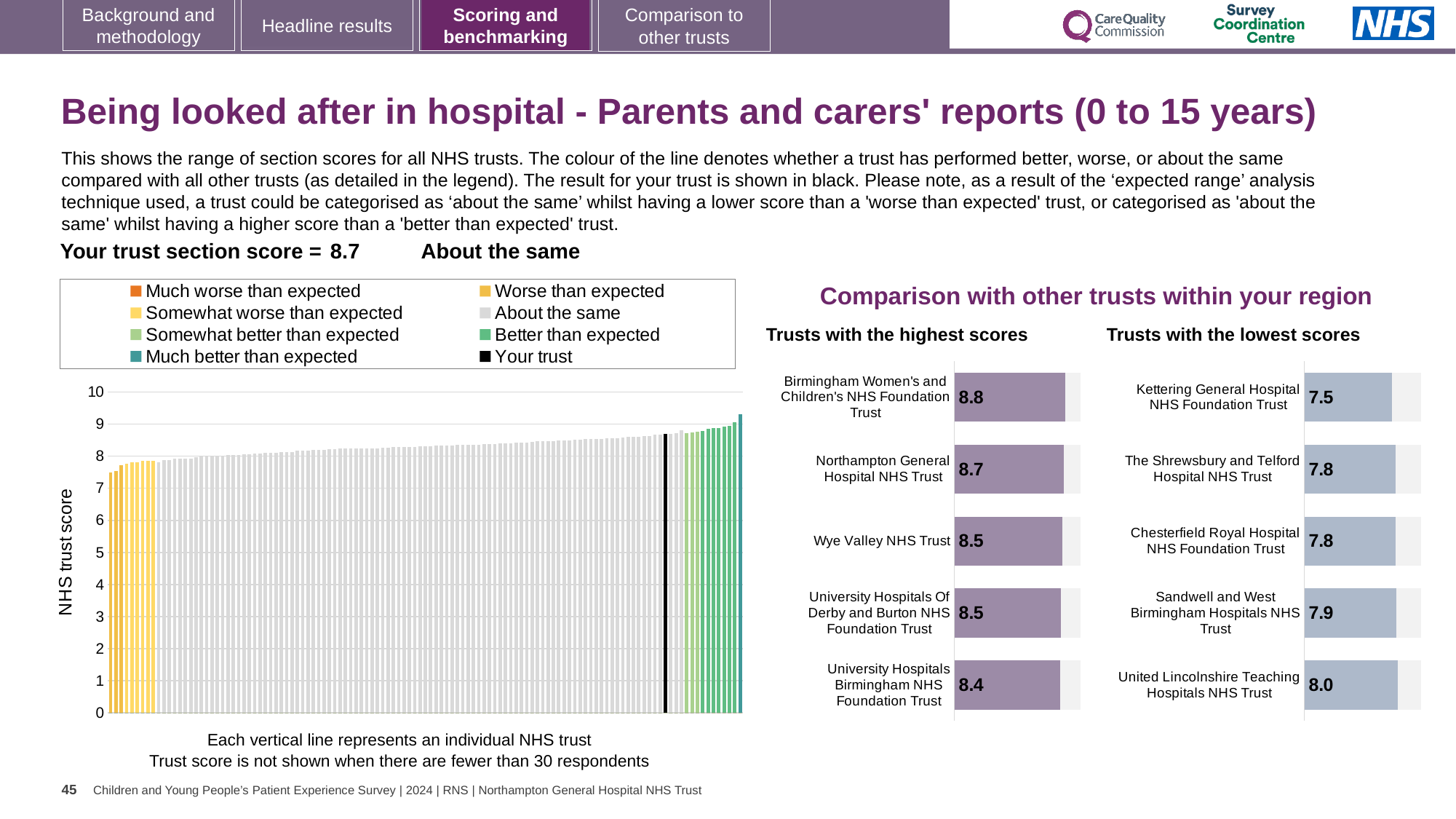
In the 'Trusts with the lowest scores' chart, what is the score for Kettering General Hospital NHS Foundation Trust? 7.5 In the 'Trusts with the lowest scores' chart, which trust has the lowest score? Kettering General Hospital NHS Foundation Trust In the 'Trusts with the highest scores' chart, what is the score for Birmingham Women's and Children's NHS Foundation Trust? 8.8 In the 'Trusts with the lowest scores' chart, what is the difference between the scores of United Lincolnshire Teaching Hospitals NHS Trust and Kettering General Hospital NHS Foundation Trust? 0.5 In the main 'NHS trust score' chart, do the values rise or fall from left to right? Rise How many entries does the legend of the main 'NHS trust score' chart list? 8 What kind of chart is the main chart on the left showing NHS trust scores? Bar chart In the 'Trusts with the highest scores' chart, what is the difference between the scores of Birmingham Women's and Children's NHS Foundation Trust and University Hospitals Birmingham NHS Foundation Trust? 0.4 In the 'Trusts with the highest scores' chart, which trust has the highest score? Birmingham Women's and Children's NHS Foundation Trust What is the label on the vertical axis of the main chart on the left? NHS trust score In the 'Trusts with the lowest scores' chart, which has the larger score: Sandwell and West Birmingham Hospitals NHS Trust or The Shrewsbury and Telford Hospital NHS Trust? Sandwell and West Birmingham Hospitals NHS Trust How many trusts are shown in the 'Trusts with the highest scores' chart? 5